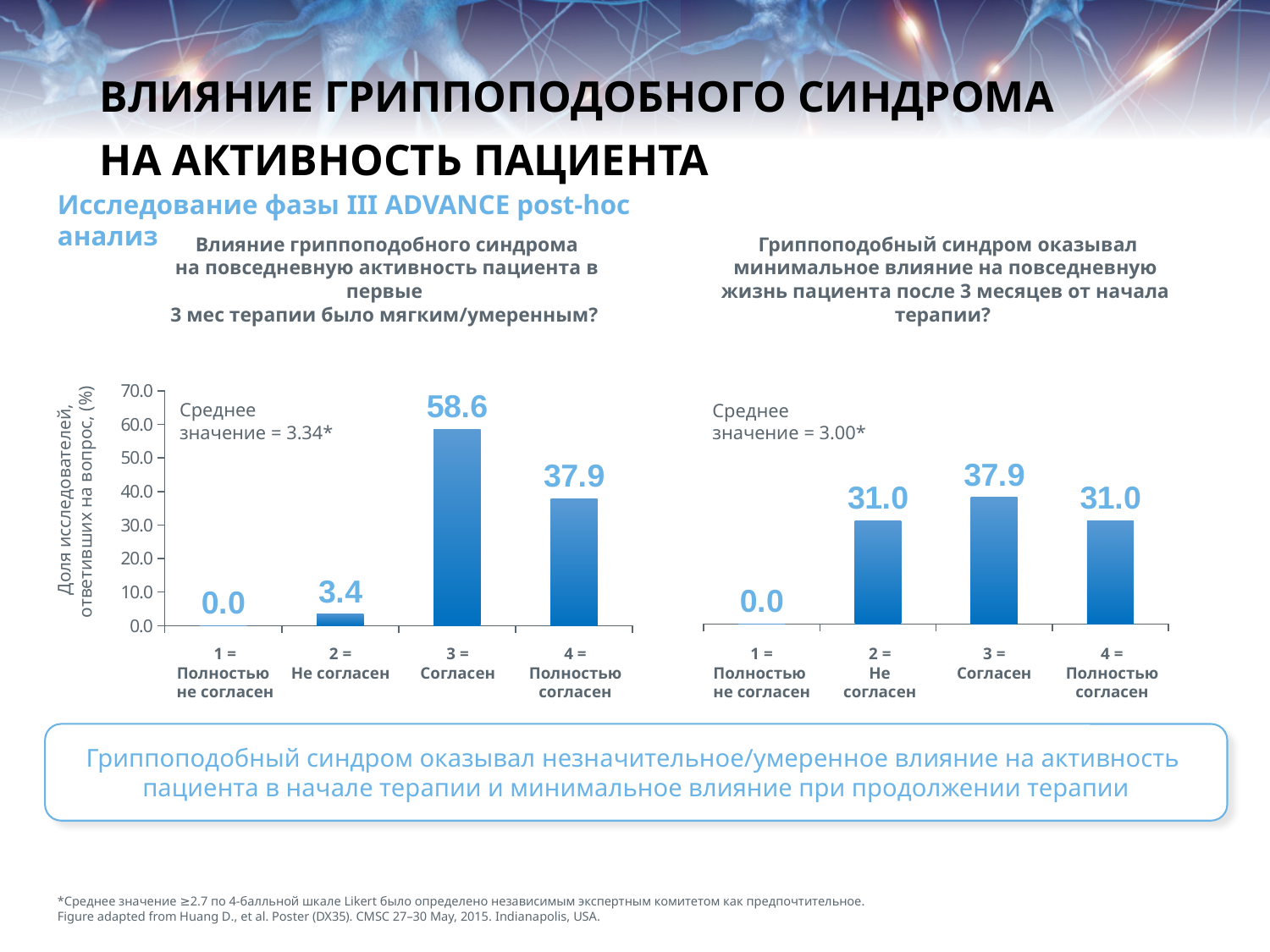
In the left chart, what is the difference between the values for '3 = Согласен' and '4 = Полностью согласен'? 20.7 In the right chart, what is the value for '4 = Полностью согласен'? 31.0 In the left chart, what is the value for '2 = Не согласен'? 3.4 In the left chart, which is larger: the value for '3 = Согласен' or the value for '4 = Полностью согласен'? 3 = Согласен What mean value (Среднее значение) is stated on the right chart? 3.00* In the left chart, what is the value for '3 = Согласен'? 58.6 In the left chart, which category has the highest value? 3 = Согласен How many categories are shown on the x axis of the right chart? 4 In the right chart, which category has the lowest value? 1 = Полностью не согласен In the right chart, what is the value for '3 = Согласен'? 37.9 What kind of chart is the left chart? Bar chart In the right chart, what is the difference between the values for '3 = Согласен' and '2 = Не согласен'? 6.9